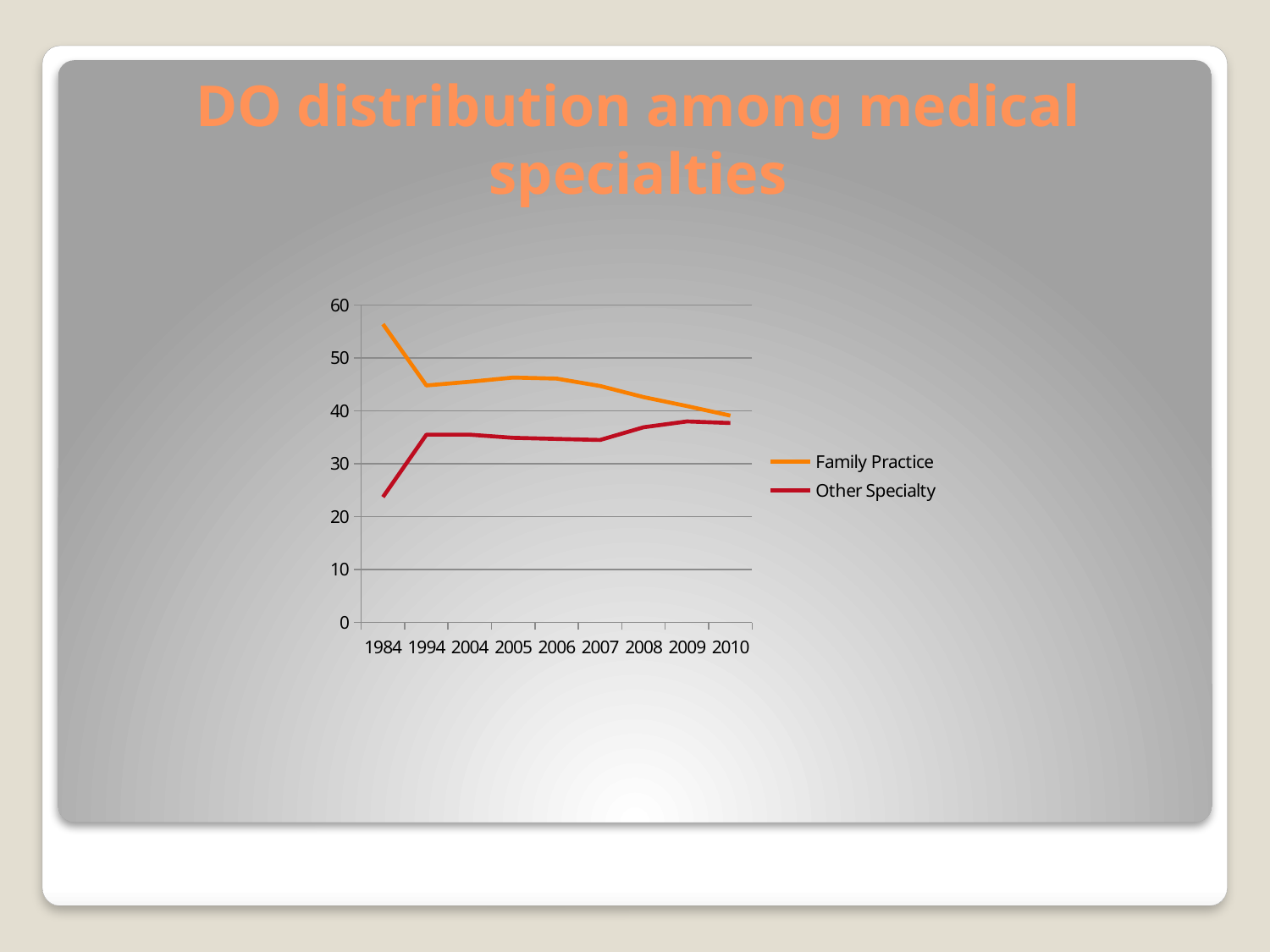
Does the Family Practice line rise or fall from 1984 to 2010? fall How many series does the legend list? 2 Is the value for Family Practice in 1984 greater or less than 50? greater What kind of chart is shown on the slide? line chart In which year is the Family Practice value highest? 1984 In which year is the Other Specialty value lowest? 1984 Does the Other Specialty line rise or fall from 1984 to 2010? rise How many years are plotted along the x axis? 9 What is the title of the chart on the slide? DO distribution among medical specialties Is the value for Other Specialty in 1984 greater or less than 30? less Which series is drawn in orange? Family Practice